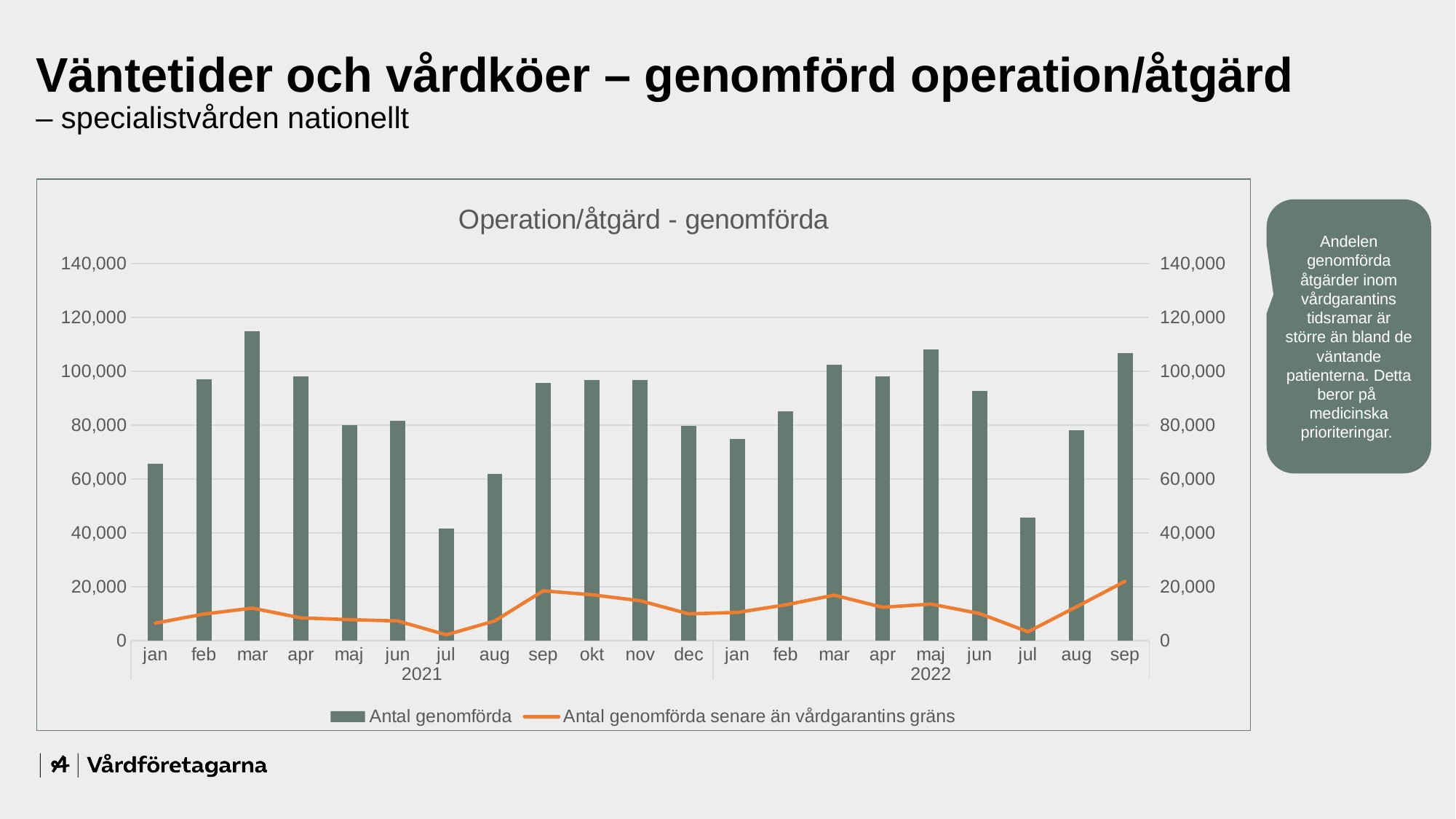
In which month does the line for Antal genomförda senare än vårdgarantins gräns reach its highest point? sep 2022 Is the value for Antal genomförda in jul 2021 greater or less than 60,000? less In which month is the bar for Antal genomförda highest? mar 2021 How many months are plotted along the x axis? 21 Is the value for Antal genomförda in mar 2021 greater or less than 100,000? greater Which is larger, Antal genomförda in sep 2022 or in aug 2022? sep 2022 Do the bars for Antal genomförda rise or fall from jan 2021 to mar 2021? rise How many series does the legend list? 2 Is the value for Antal genomförda in jul 2022 greater or less than 60,000? less In which month is the bar for Antal genomförda lowest? jul 2021 What is the title of the chart? Operation/åtgärd - genomförda What kind of chart is shown on the slide? A combined bar and line chart